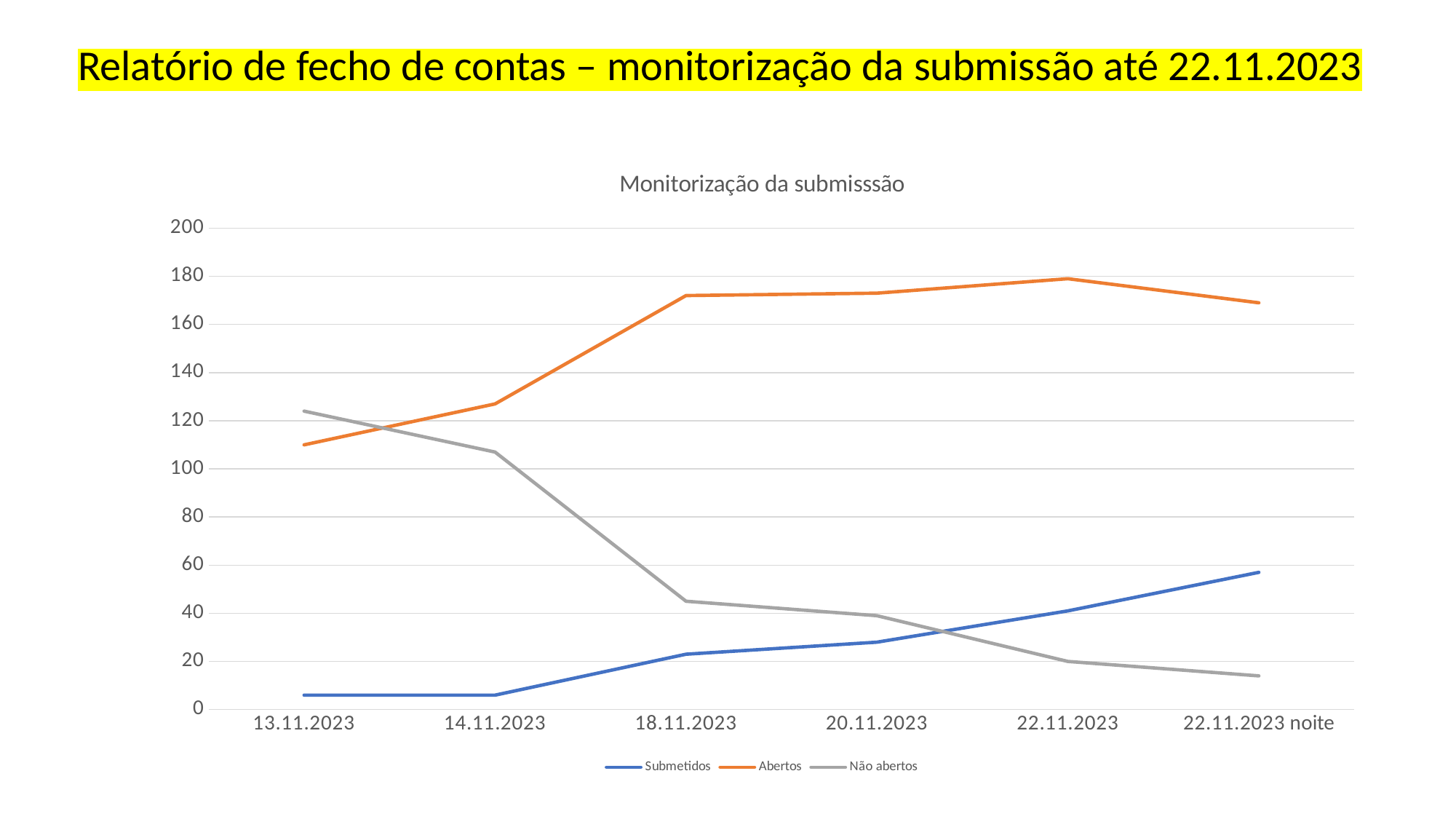
How many series does the legend list? 3 Is the value for Não abertos at 13.11.2023 greater or less than 100? greater Is the value for Abertos at 18.11.2023 greater or less than 160? greater Is the value for Submetidos at 22.11.2023 noite greater or less than 40? greater At 18.11.2023, which is larger: Submetidos or Não abertos? Não abertos What is the title of the chart? Monitorização da submisssão What kind of chart is shown on the slide? line chart Does the Não abertos series rise or fall from 13.11.2023 to 22.11.2023 noite? fall Which series is drawn in orange? Abertos At 22.11.2023 noite, which is larger: Submetidos or Não abertos? Submetidos How many dates are shown along the x axis? 6